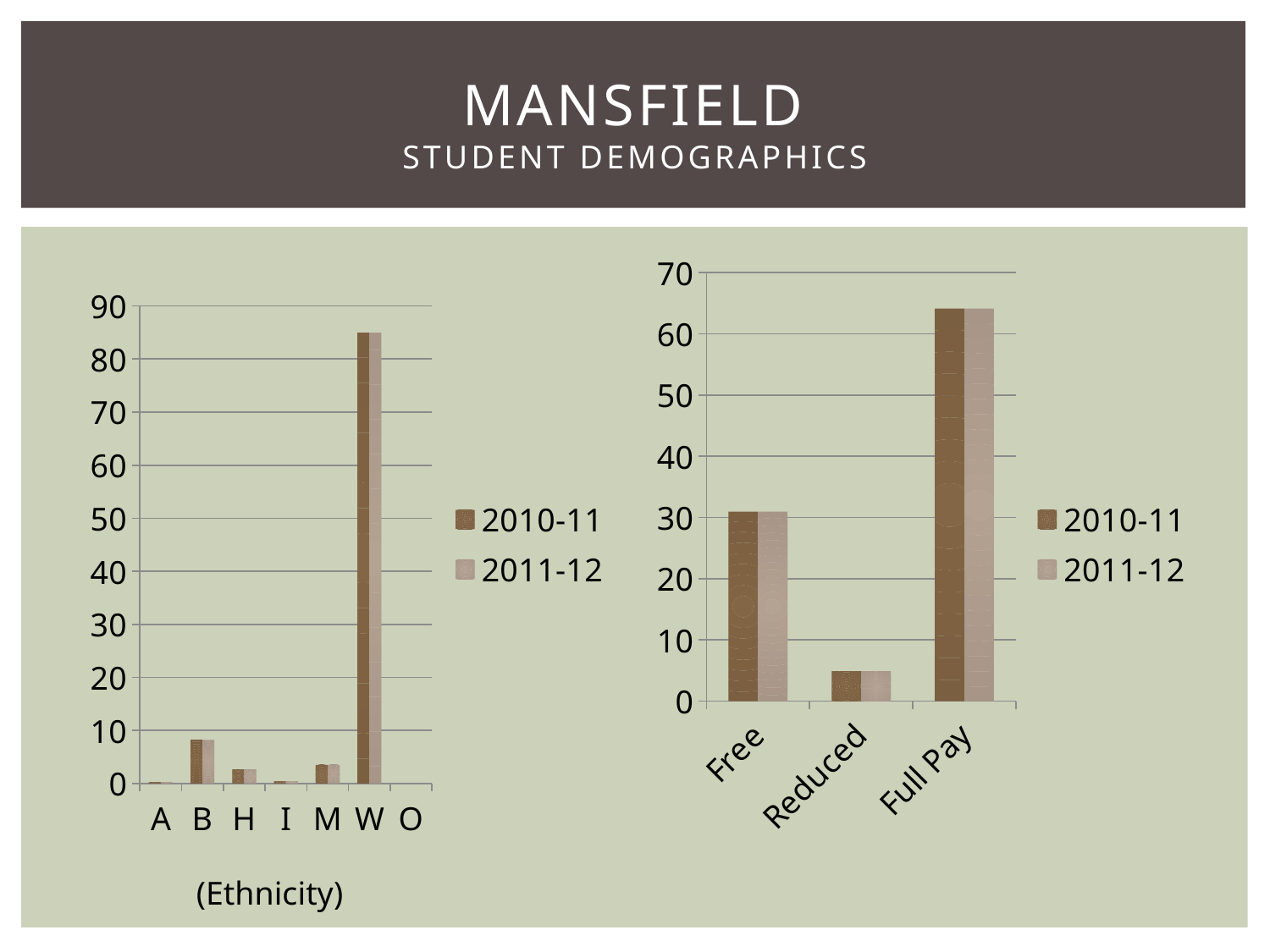
How many categories are shown on the left chart (Ethnicity)? 7 On the right chart, is the 2011-12 value for Reduced greater or less than 10? less On the left chart (Ethnicity), is the 2010-11 value for H greater or less than 10? less On the left chart (Ethnicity), which is larger, the 2010-11 value for B or the 2010-11 value for M? B On the right chart, which category has the highest value? Full Pay On the left chart (Ethnicity), is the 2010-11 value for W greater or less than 80? greater What kind of chart is the right chart? bar chart On the left chart (Ethnicity), which category has the highest value? W On the right chart, which category has the lowest value? Reduced How many series does the legend of the left chart (Ethnicity) list? 2